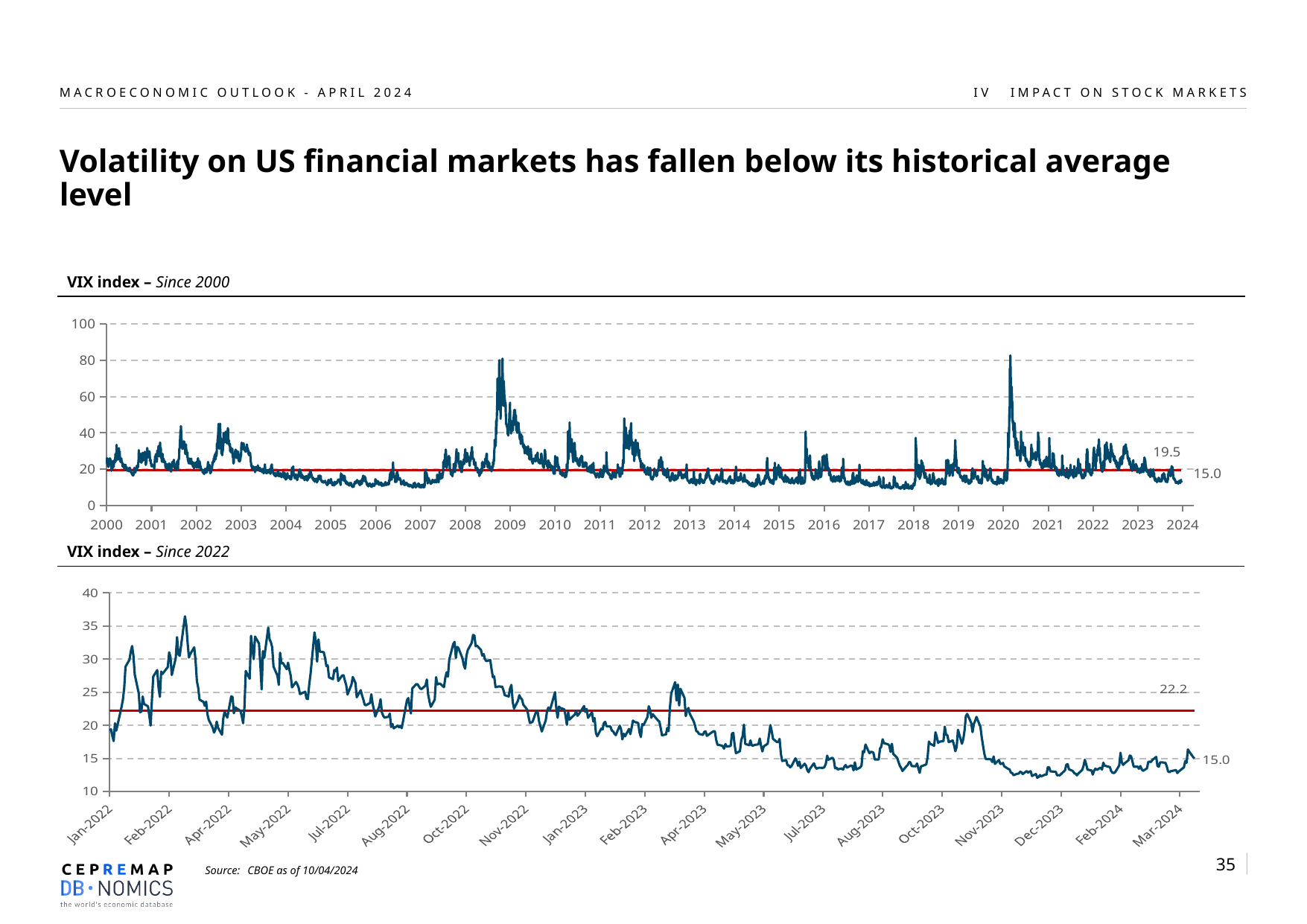
What is the highest value shown on the y axis of the 'VIX index – Since 2000' chart? 100 In the 'VIX index – Since 2000' chart, is the peak value reached in 2020 greater or less than 60? greater In the 'VIX index – Since 2022' chart, what is the difference between the average line value and the latest VIX value? 7.2 In the 'VIX index – Since 2000' chart, what value is labelled on the red horizontal average line? 19.5 In the 'VIX index – Since 2000' chart, what is the latest value labelled at the end of the VIX line? 15.0 In the 'VIX index – Since 2022' chart, what is the latest value labelled at the end of the VIX line? 15.0 In the 'VIX index – Since 2000' chart, is the latest VIX value greater or less than the historical average line? less In the 'VIX index – Since 2000' chart, what is the difference between the average line value and the latest VIX value? 4.5 What kind of chart is the 'VIX index – Since 2000' chart? line chart In the 'VIX index – Since 2022' chart, what value is labelled on the red horizontal average line? 22.2 In the 'VIX index – Since 2022' chart, is the VIX value in Mar-2024 greater or less than 20? less In the 'VIX index – Since 2022' chart, does the VIX generally rise or fall from Jan-2022 to Mar-2024? fall